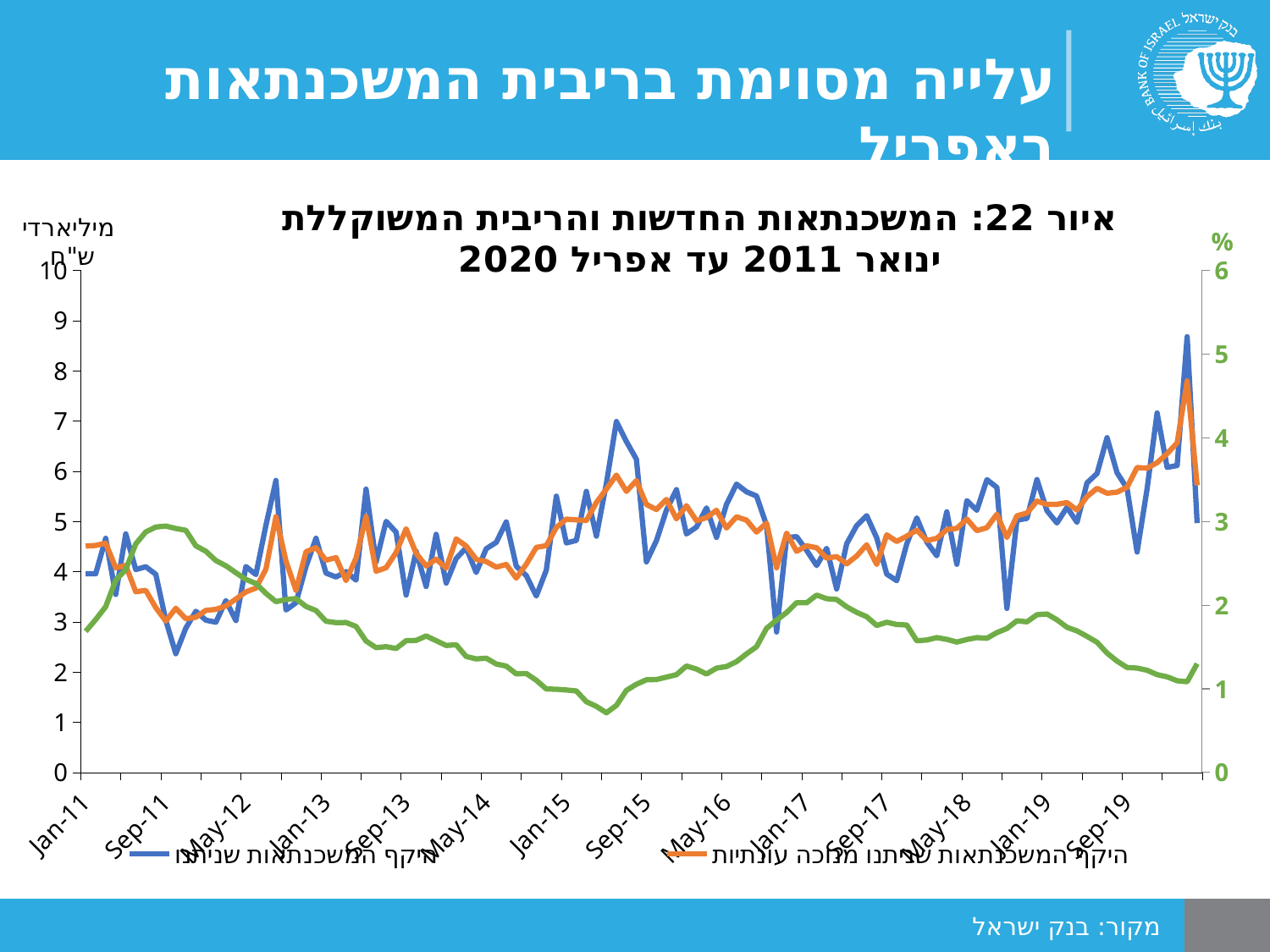
What is the title of the chart? איור 22: המשכנתאות החדשות והריבית המשוקללת ינואר 2011 עד אפריל 2020 What kind of chart is shown on the slide? line chart What unit is shown on the left vertical axis of the chart? מיליארדי ש"ח Does the orange line (היקף המשכנתאות שניתנו מנוכה עונתיות) generally rise or fall from Jan-17 to the end of the series? rise Does the green line generally rise or fall between Sep-11 and Jan-15? fall Is the peak value of the blue line (היקף המשכנתאות שניתנו) in early 2020 greater or less than 8 on the left axis? greater How many lines are plotted on the chart? 3 What is the first date label on the x axis? Jan-11 Is the peak value of the orange line (היקף המשכנתאות שניתנו מנוכה עונתיות) in early 2020 greater or less than 7 on the left axis? greater Which line reaches the highest value on the left axis: the blue line or the orange line? the blue line Around Sep-15, which is larger: the blue line or the orange line? the orange line